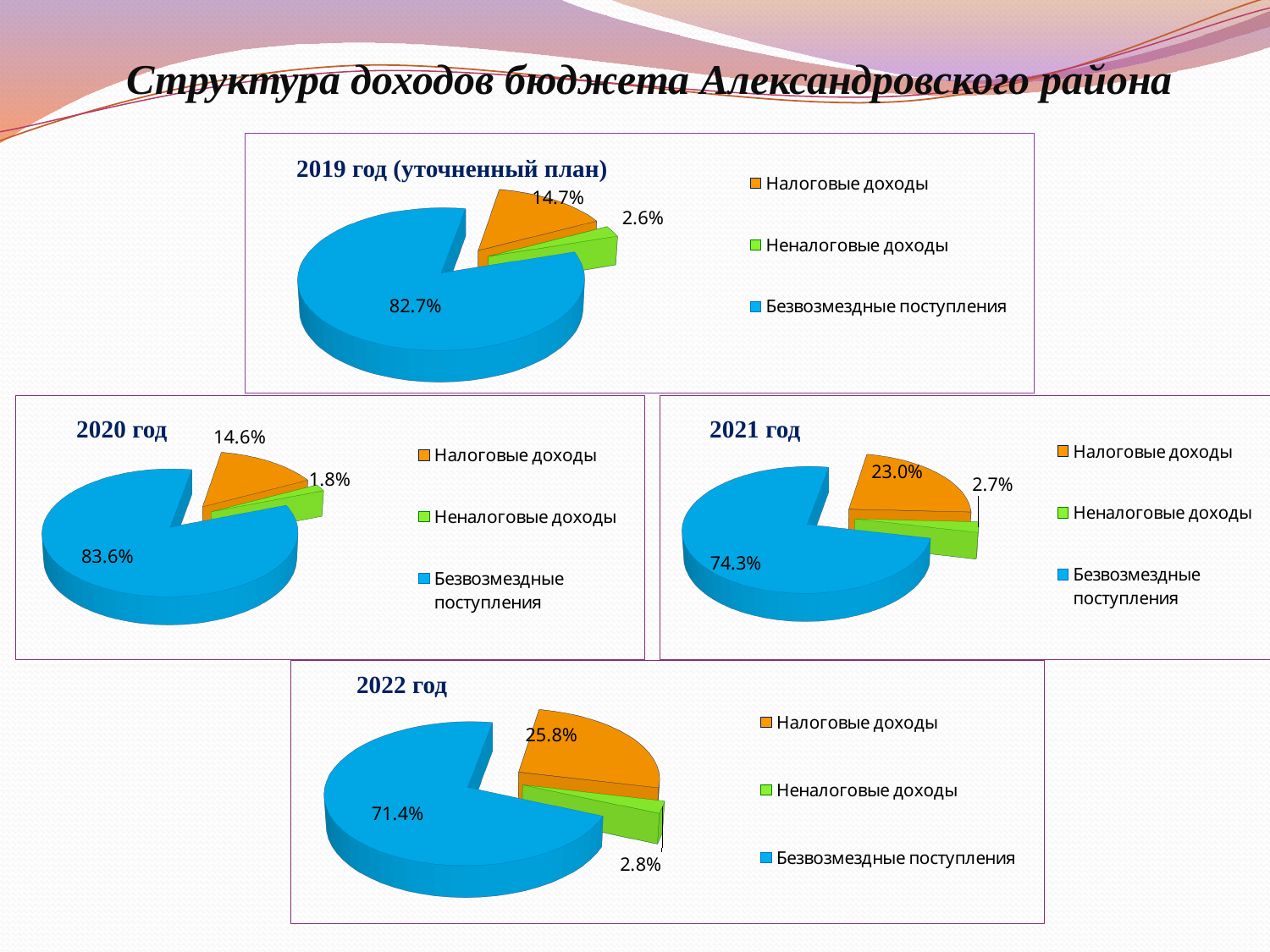
In the "2021 год" chart, what share is labelled for Неналоговые доходы? 2.7% In the "2022 год" chart, what share is labelled for Безвозмездные поступления? 71.4% In the "2020 год" chart, what share is labelled for Налоговые доходы? 14.6% In the "2022 год" chart, which category has the largest slice? Безвозмездные поступления What type of chart is the "2020 год" chart? Pie chart How many entries does the legend of the "2022 год" chart list? 3 What colour represents Неналоговые доходы in the "2019 год (уточненный план)" chart? Green In the "2019 год (уточненный план)" chart, what share is labelled for Безвозмездные поступления? 82.7% In the "2021 год" chart, what is the difference between the shares of Налоговые доходы and Неналоговые доходы? 20.3% How many slices does the "2021 год" pie chart have? 3 Which is larger: the Налоговые доходы share in the "2019 год (уточненный план)" chart or in the "2022 год" chart? 2022 год In the "2020 год" chart, which category has the smallest slice? Неналоговые доходы